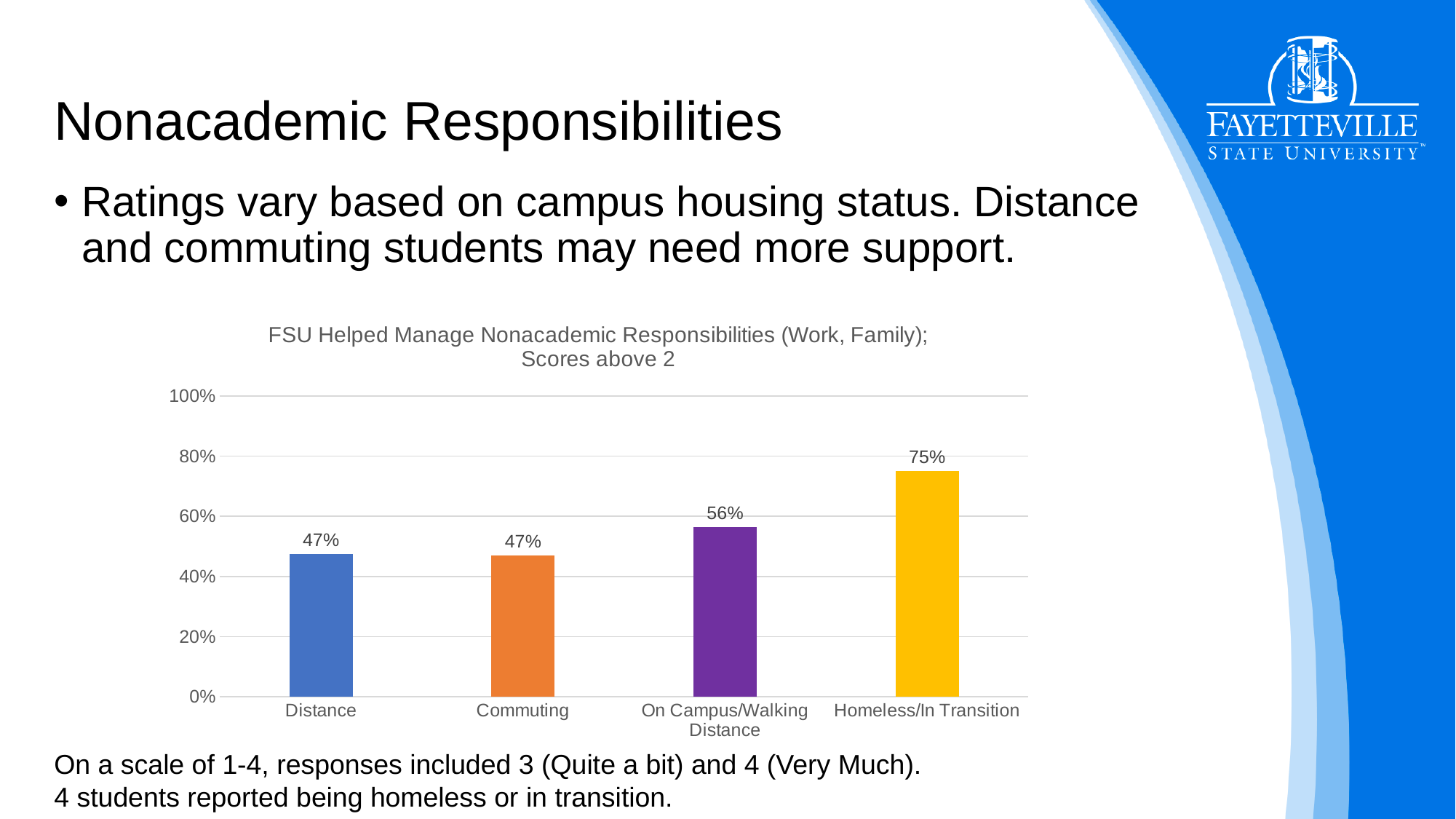
What is the value for On Campus/Walking Distance? 56% What is the difference between the values for On Campus/Walking Distance and Commuting? 9% What is the value for Distance? 47% What kind of chart is shown on the slide? bar chart Which category has the highest value? Homeless/In Transition Which is larger, the value for On Campus/Walking Distance or the value for Distance? On Campus/Walking Distance What is the title of the chart? FSU Helped Manage Nonacademic Responsibilities (Work, Family); Scores above 2 Do the values rise or fall from left to right across the categories? rise Is the value for Homeless/In Transition greater or less than 60%? greater How many categories are shown in the chart? 4 What is the value for Homeless/In Transition? 75% What is the difference between the values for Homeless/In Transition and On Campus/Walking Distance? 19%